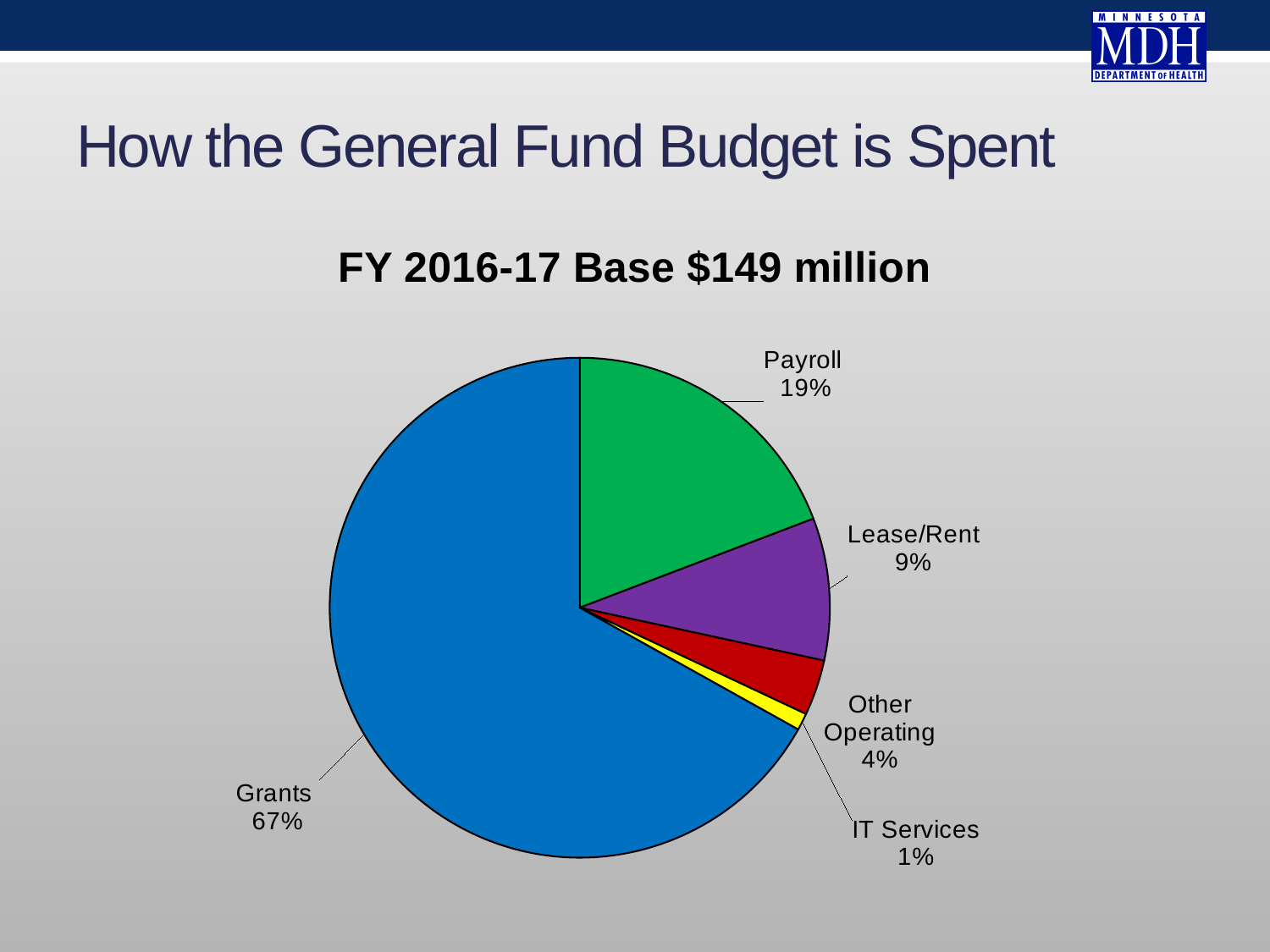
What kind of chart is shown on the slide? pie chart What share of the General Fund budget goes to Lease/Rent? 9% What share of the General Fund budget goes to Grants? 67% What is the title shown above the pie chart? FY 2016-17 Base $149 million Which category has the smallest share of the pie? IT Services What share of the General Fund budget goes to Other Operating? 4% How many slices does the pie chart have? 5 Which category has the largest share of the pie? Grants Which is larger, the share for Lease/Rent or the share for Other Operating? Lease/Rent What is the difference in percentage points between Grants and Payroll? 48